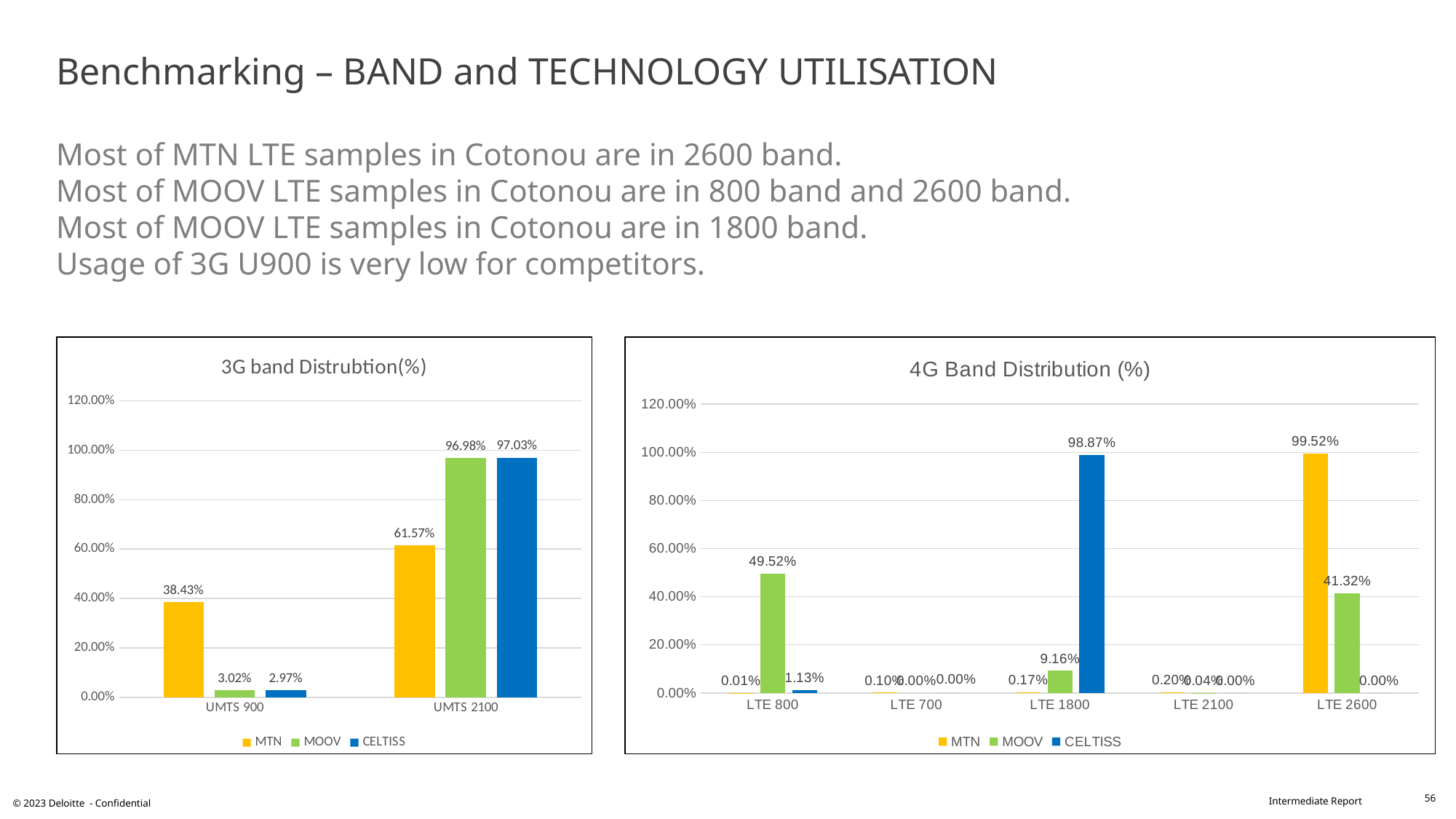
In the 4G Band Distribution (%) chart, what is the value for CELTISS in LTE 1800? 98.87% In the 3G band Distrubtion(%) chart, what is the value for MTN in UMTS 900? 38.43% In the 3G band Distrubtion(%) chart, which operator has the highest value in UMTS 900? MTN In the 4G Band Distribution (%) chart, is MOOV's value in LTE 2600 larger or smaller than its value in LTE 800? smaller In the 3G band Distrubtion(%) chart, what is the difference between MTN's UMTS 2100 and UMTS 900 values? 23.14% In the 3G band Distrubtion(%) chart, what is the value for CELTISS in UMTS 2100? 97.03% In the 4G Band Distribution (%) chart, which band has the highest value for MTN? LTE 2600 In the 4G Band Distribution (%) chart, what is the difference between MOOV's LTE 800 and LTE 2600 values? 8.20% What type of chart is the 4G Band Distribution (%) chart? bar chart In the 4G Band Distribution (%) chart, what is the value for MOOV in LTE 800? 49.52% How many bands are shown on the x axis of the 4G Band Distribution (%) chart? 5 In the 3G band Distrubtion(%) chart, how many series does the legend list? 3